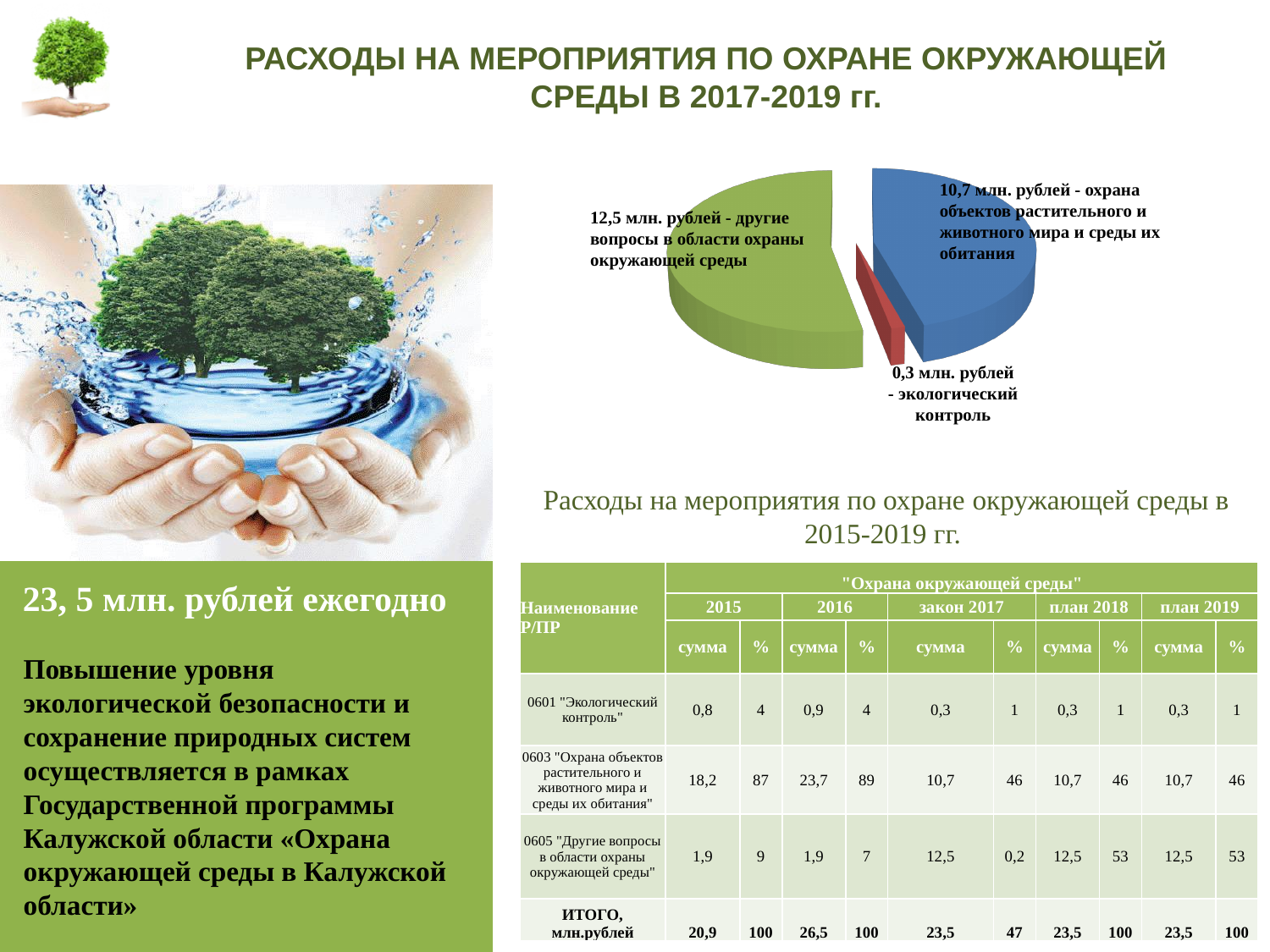
What is the value of the pie slice for экологический контроль? 0,3 млн. рублей What colour is the slice for охрана объектов растительного и животного мира и среды их обитания? blue Which is larger in the pie chart: охрана объектов растительного и животного мира or экологический контроль? охрана объектов растительного и животного мира What kind of chart is shown on the slide? pie chart Which slice of the pie chart is the smallest? экологический контроль What is the value of the pie slice for другие вопросы в области охраны окружающей среды? 12,5 млн. рублей What is the value of the pie slice for охрана объектов растительного и животного мира и среды их обитания? 10,7 млн. рублей What is the difference between the slice for другие вопросы в области охраны окружающей среды and the slice for охрана объектов растительного и животного мира? 1,8 млн. рублей What colour is the slice for экологический контроль in the pie chart? red What is the total of all three slices in the pie chart? 23,5 млн. рублей How many slices does the pie chart have? 3 Which slice of the pie chart is the largest? другие вопросы в области охраны окружающей среды